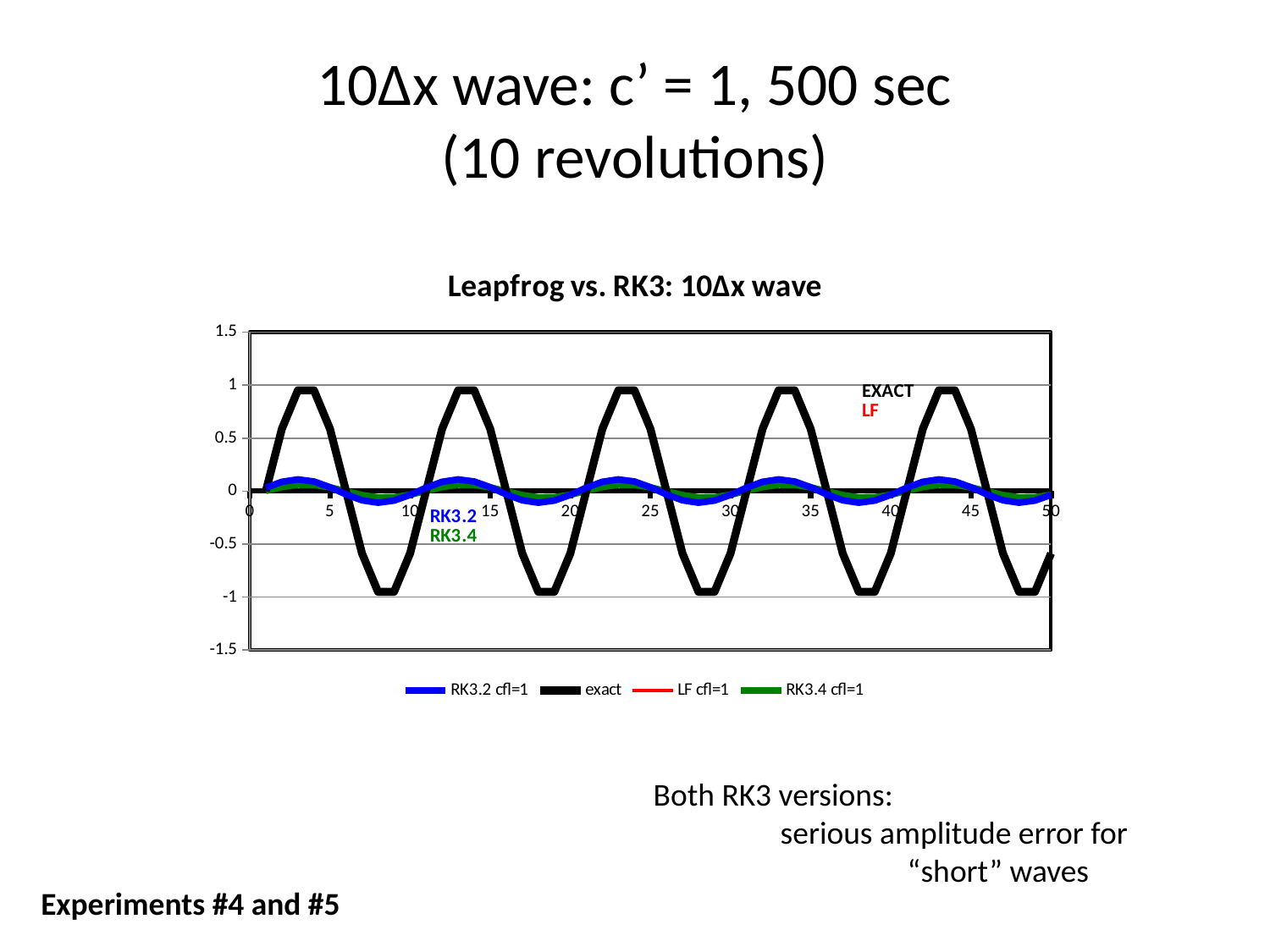
Which series in the legend is drawn in black? exact Which series has the larger amplitude, RK3.2 cfl=1 or RK3.4 cfl=1? RK3.2 cfl=1 What is the largest value shown on the x axis of the chart? 50 Is the peak value of the exact series greater or less than 0.5? greater What kind of chart is shown on the slide? line chart Is the minimum value of the exact series greater or less than -0.5? less Which series has the larger amplitude, exact or RK3.2 cfl=1? exact What is the highest value shown on the y axis of the chart? 1.5 Is the peak value of the RK3.2 cfl=1 series greater or less than 0.5? less How many series does the legend of the chart list? 4